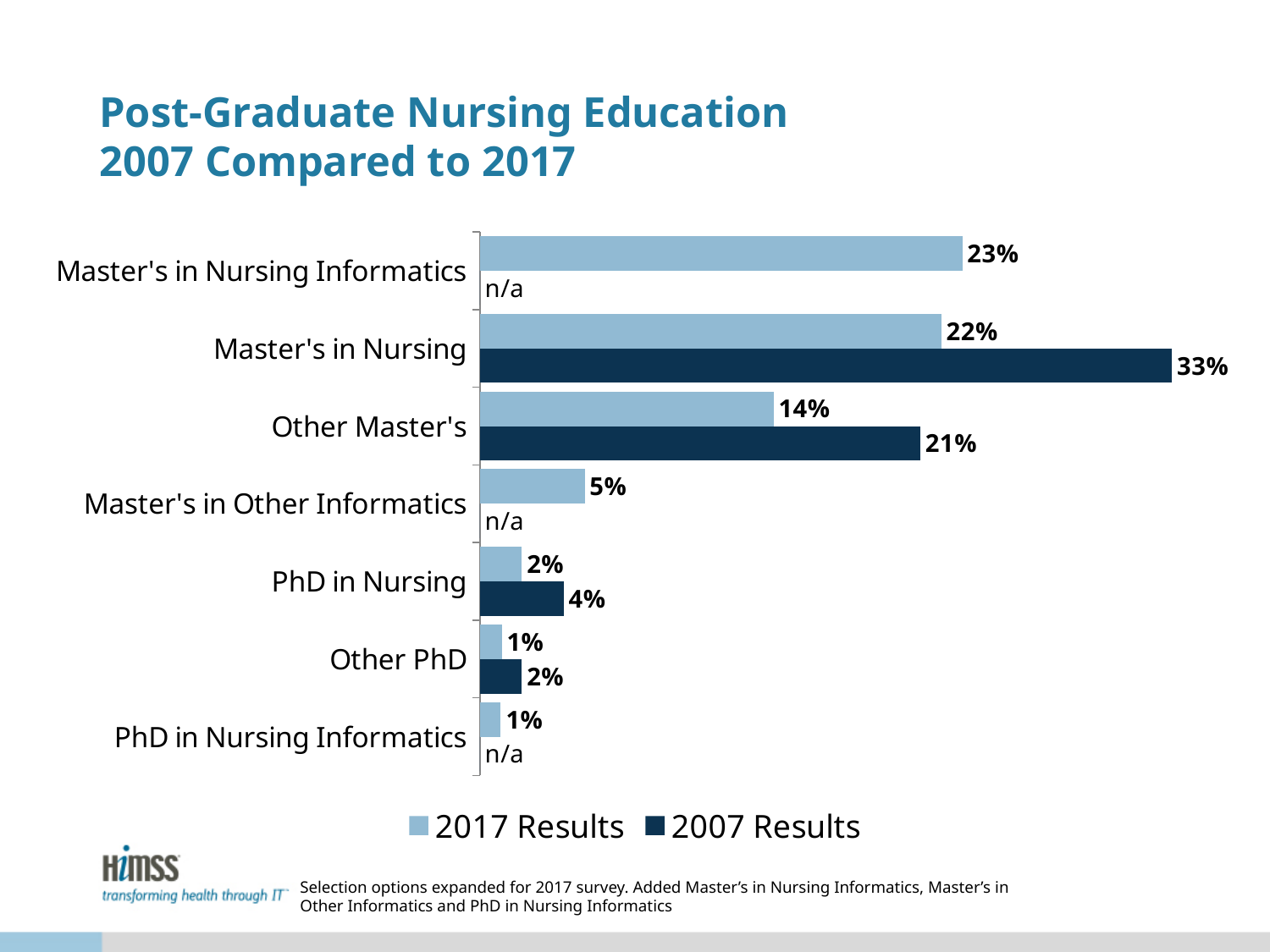
What is the 2017 Results value for Other Master's? 14% Which category has the highest 2017 Results value? Master's in Nursing Informatics Which is larger for Other PhD: the 2017 Results value or the 2007 Results value? 2007 Results What is the difference between the 2007 Results and 2017 Results values for Master's in Nursing? 11% What is the 2007 Results value for PhD in Nursing? 4% What is the difference between the 2007 Results and 2017 Results values for Other Master's? 7% How many categories are shown on the chart? 7 What kind of chart is shown on the slide? Bar chart How many series does the legend list? 2 What is the 2017 Results value for Master's in Nursing Informatics? 23% Which category has the highest 2007 Results value? Master's in Nursing What is the 2007 Results value for Master's in Nursing? 33%